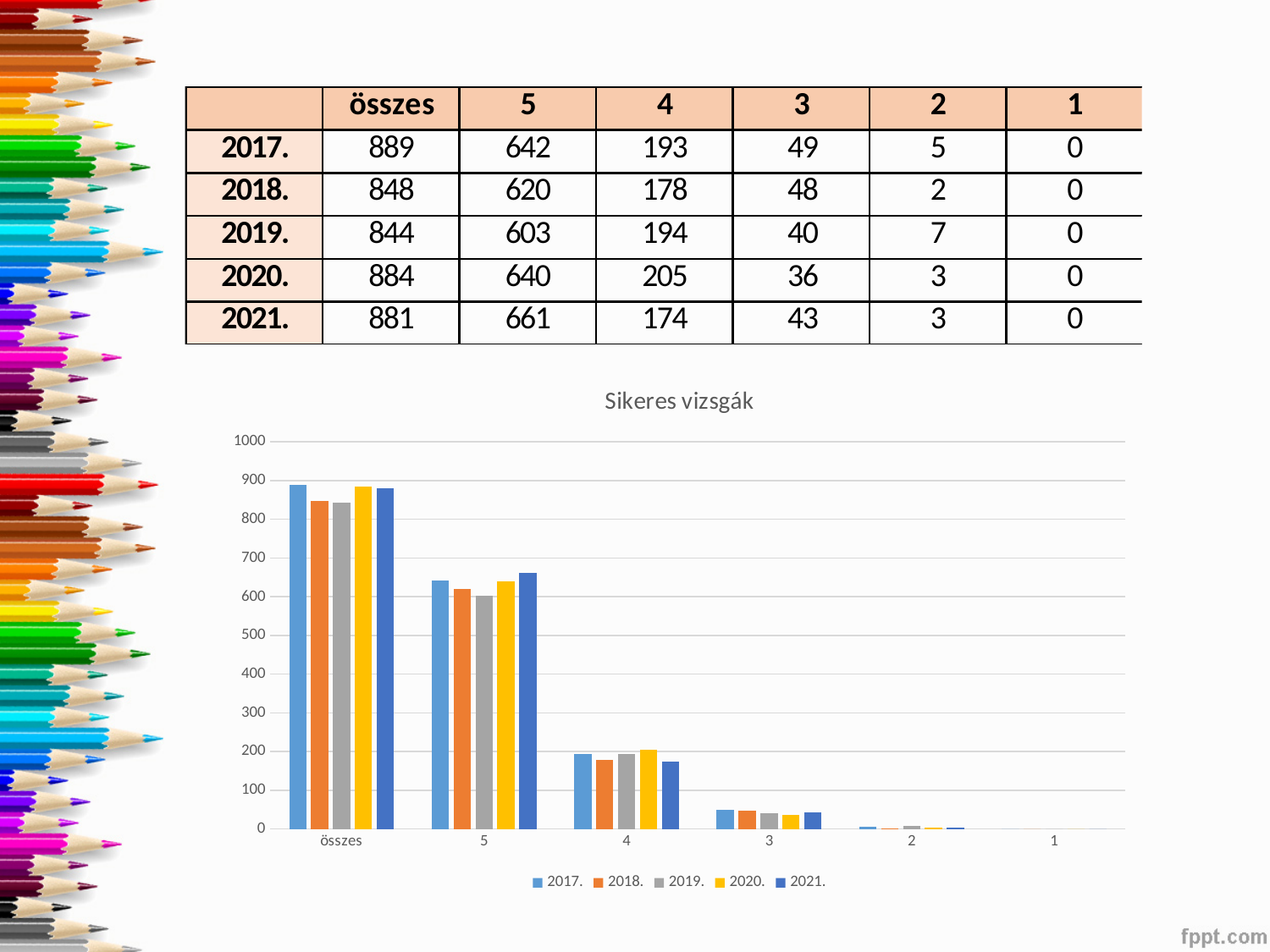
How many series does the legend of the chart list? 5 In the chart, what is the value for 2021. in the "összes" category? 881 In the chart, which year has the highest value in category 5? 2021. In the chart, which is larger: the 2017. value or the 2019. value in category 3? 2017. In the chart, what is the value for 2019. in category 5? 603 In the chart, which year has the lowest value in category 4? 2021. In the chart, is the value for 2020. in category 4 greater or less than 200? greater How many categories are shown on the x axis of the chart? 6 In the chart, what is the difference between the 2021. and 2018. values in category 5? 41 In the chart, is the value for 2018. in the "összes" category greater or less than 900? less What type of chart is "Sikeres vizsgák"? bar chart What is the title of the chart? Sikeres vizsgák